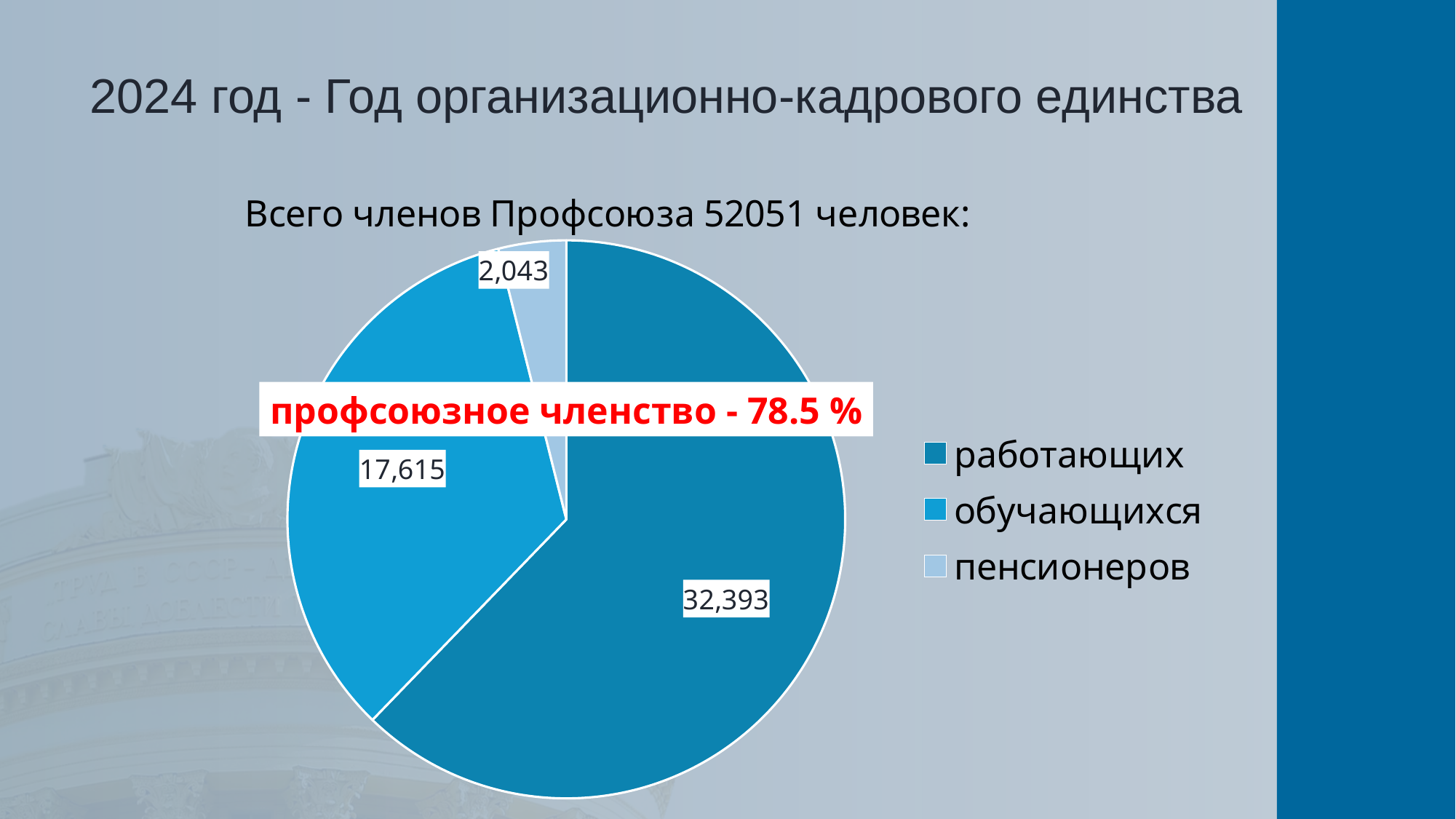
How many members are in the работающих category? 32,393 What union membership percentage is shown in the red text over the chart? 78.5 % What is the total number of union members stated above the chart? 52051 What type of chart is shown on the slide? pie chart How many categories does the pie chart have? 3 What is the difference between the обучающихся and пенсионеров values? 15,572 What is the difference between the работающих and обучающихся values? 14,778 Which category has the largest slice of the pie? работающих How many members are in the обучающихся category? 17,615 Which is larger, the обучающихся value or the пенсионеров value? обучающихся How many members are in the пенсионеров category? 2,043 Which category has the smallest slice of the pie? пенсионеров